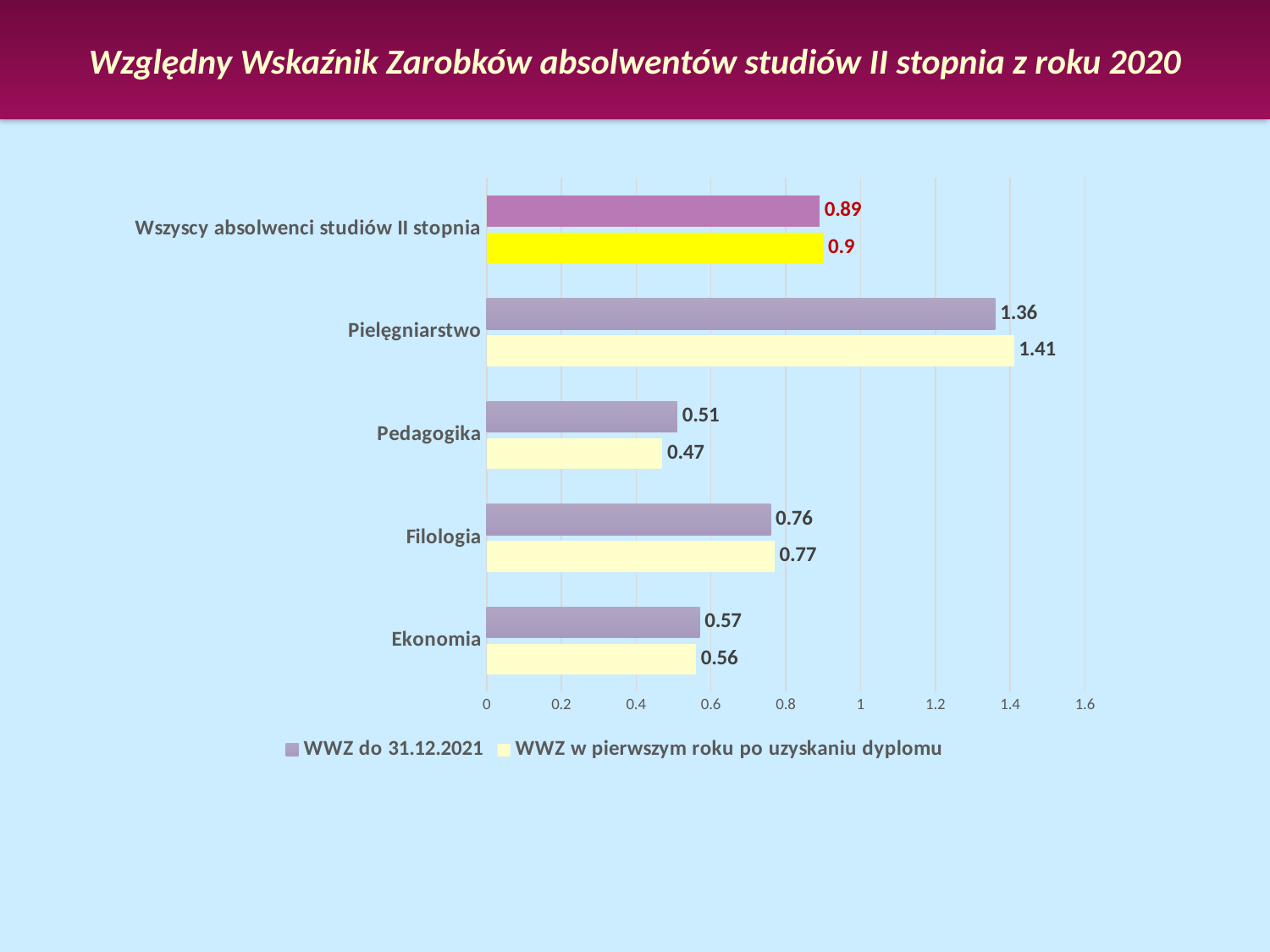
Which category has the highest value for WWZ w pierwszym roku po uzyskaniu dyplomu? Pielęgniarstwo How many series does the legend list? 2 Is the value of WWZ do 31.12.2021 for Pielęgniarstwo greater or less than 1.2? greater What is the value of WWZ w pierwszym roku po uzyskaniu dyplomu for Wszyscy absolwenci studiów II stopnia? 0.9 What kind of chart is shown on the slide? Bar chart What is the value of WWZ w pierwszym roku po uzyskaniu dyplomu for Pedagogika? 0.47 What is the value of WWZ do 31.12.2021 for Pielęgniarstwo? 1.36 What is the difference between the WWZ w pierwszym roku po uzyskaniu dyplomu and WWZ do 31.12.2021 values for Pielęgniarstwo? 0.05 What is the value of WWZ do 31.12.2021 for Ekonomia? 0.57 Which is larger for Filologia: WWZ do 31.12.2021 or WWZ w pierwszym roku po uzyskaniu dyplomu? WWZ w pierwszym roku po uzyskaniu dyplomu Which category has the lowest value for WWZ do 31.12.2021? Pedagogika How many categories are shown on the chart? 5